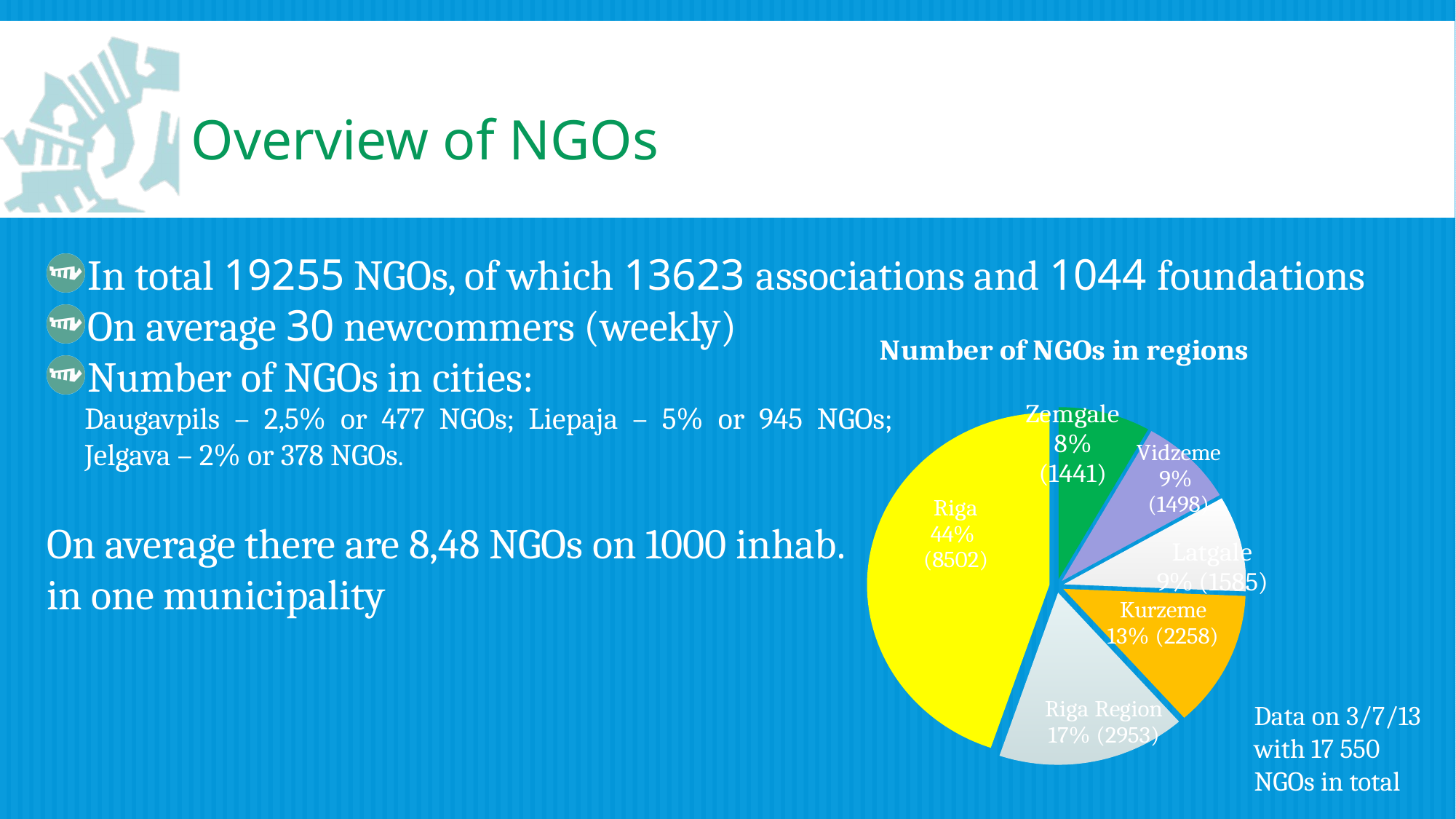
Which region has the smallest slice in the pie chart? Zemgale What percentage of NGOs does the Riga slice represent in the pie chart? 44% How many regions are shown as slices in the pie chart? 6 How many NGOs are in Kurzeme according to the pie chart? 2258 What colour is the Riga slice in the pie chart? yellow What is the difference in the number of NGOs between Latgale and Vidzeme in the pie chart? 87 Which region has the largest slice in the pie chart? Riga Which has more NGOs in the pie chart, Kurzeme or Vidzeme? Kurzeme What is the title of the pie chart? Number of NGOs in regions How many NGOs are in Zemgale according to the pie chart? 1441 What percentage share does Riga Region have in the pie chart? 17% What kind of chart is shown on the slide? pie chart